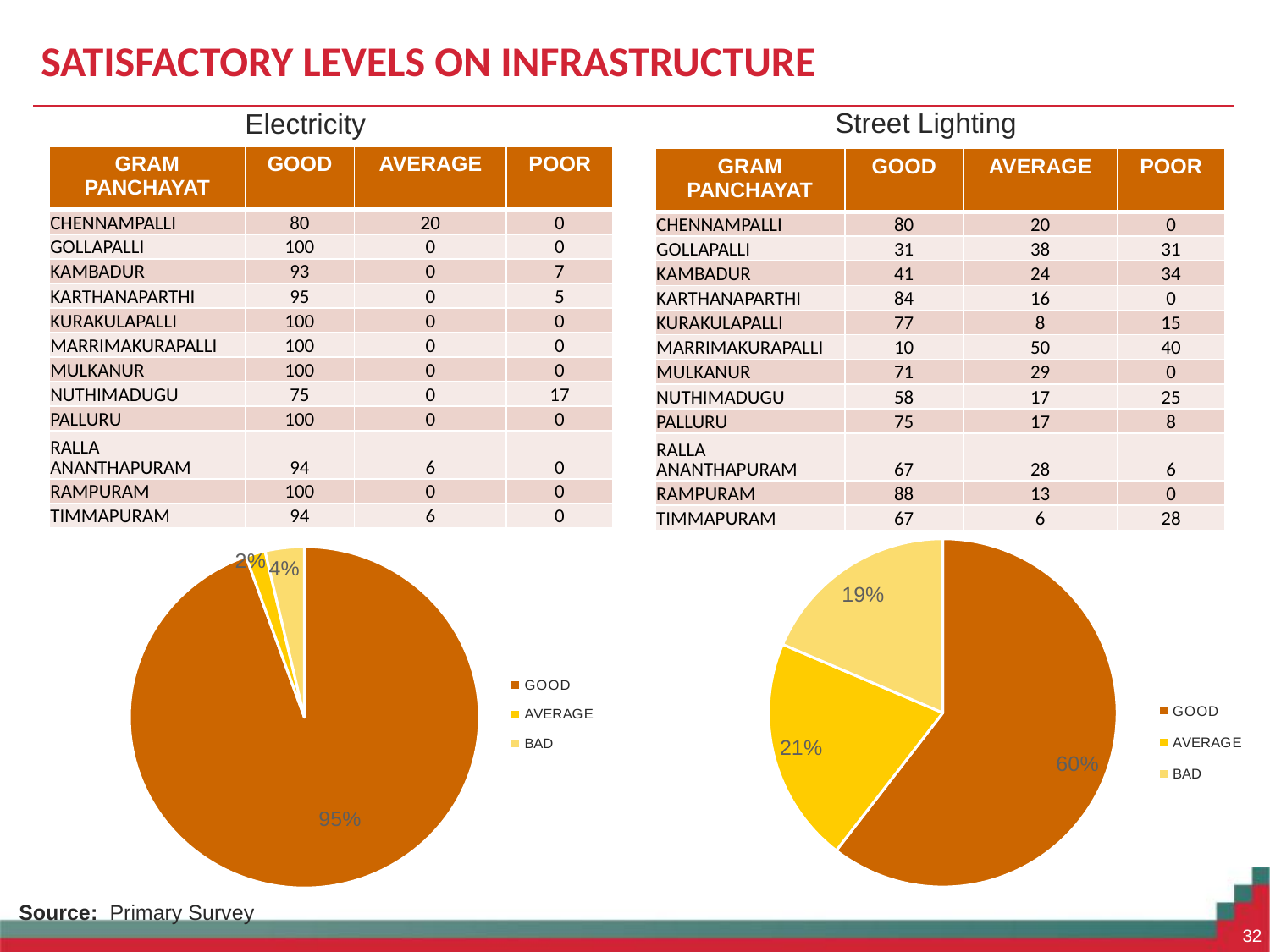
On the Electricity pie chart, what share is labelled for BAD? 4% On the Street Lighting pie chart, which is larger, AVERAGE or BAD? AVERAGE On the Street Lighting pie chart, what share is labelled for GOOD? 60% On the Street Lighting pie chart, what share is labelled for AVERAGE? 21% What type of chart is used below the Electricity table? Pie chart On the Electricity pie chart, which category has the largest slice? GOOD On the Street Lighting pie chart, which category has the largest slice? GOOD On the Street Lighting pie chart, what is the difference between the GOOD share and the AVERAGE share? 39% On the Electricity pie chart, what share is labelled for GOOD? 95% How many categories does the legend of the Street Lighting pie chart list? 3 On the Street Lighting pie chart, what share is labelled for BAD? 19% On the Street Lighting pie chart, which category has the smallest slice? BAD